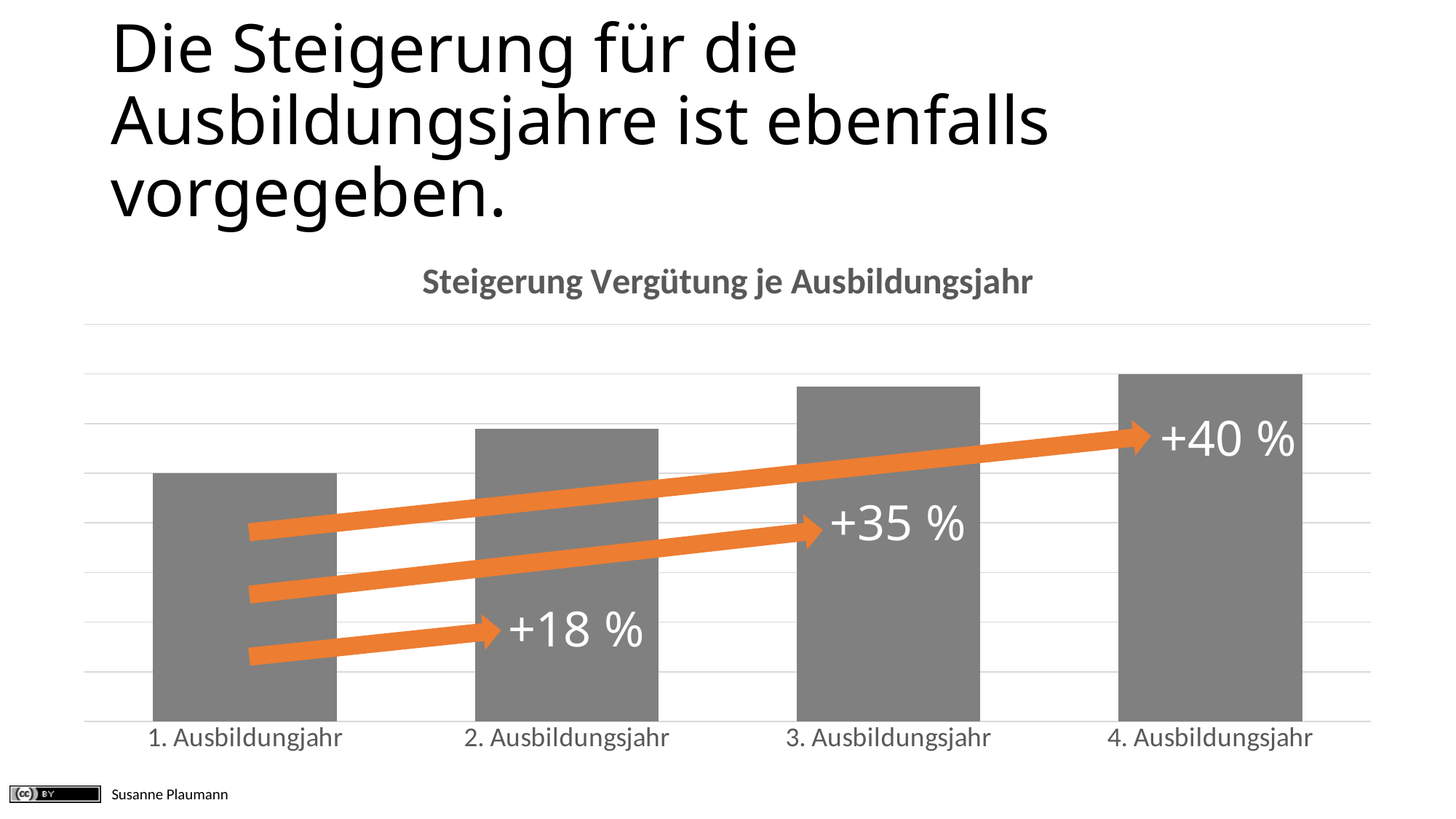
Which category has the lowest bar in the chart? 1. Ausbildungjahr Which category has the highest bar in the chart? 4. Ausbildungsjahr Do the bar values rise or fall from 1. Ausbildungjahr to 4. Ausbildungsjahr? rise Which bar is taller, 1. Ausbildungjahr or 4. Ausbildungsjahr? 4. Ausbildungsjahr What colour are the arrows drawn over the chart? orange What is the title of the chart? Steigerung Vergütung je Ausbildungsjahr Which bar is taller, 2. Ausbildungsjahr or 3. Ausbildungsjahr? 3. Ausbildungsjahr What percentage increase is labelled at the arrow pointing to the 2. Ausbildungsjahr bar? +18 % What percentage increase is labelled at the arrow pointing to the 4. Ausbildungsjahr bar? +40 % What percentage increase is labelled at the arrow pointing to the 3. Ausbildungsjahr bar? +35 % How many categories are shown on the x axis of the chart? 4 What type of chart is shown on the slide? bar chart